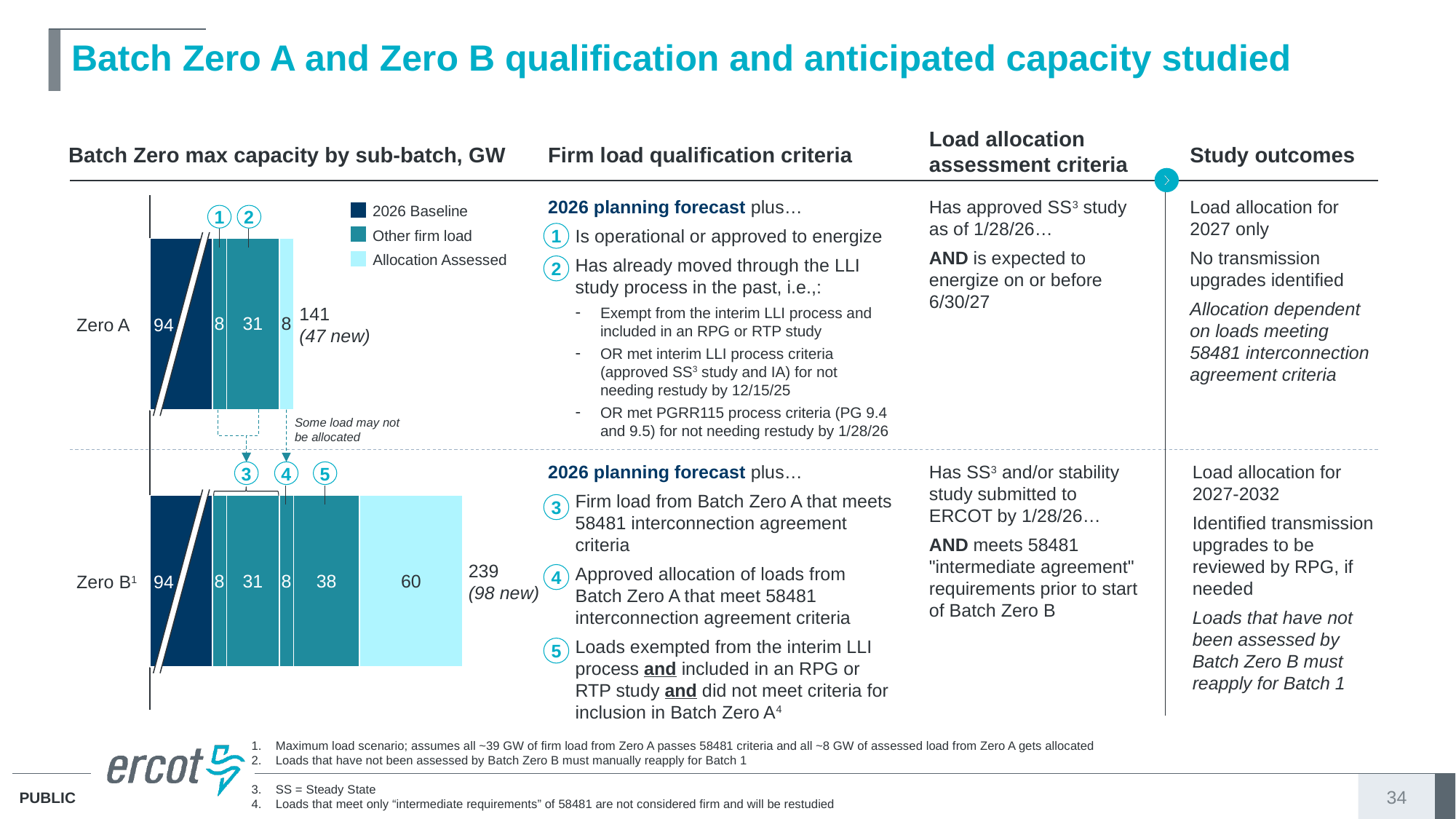
What is the total capacity shown for the Zero A bar, in GW? 141 How much new capacity is noted for Zero B? 98 new What is the value of the segment labelled 5 in the Zero B bar? 38 What is the value of the 2026 Baseline segment in the Zero A bar? 94 Which sub-batch has the higher total capacity, Zero A or Zero B? Zero B How many sub-batch bars are shown in the chart? 2 What is the difference between the Zero B total and the Zero A total, in GW? 98 What is the value of the largest Allocation Assessed segment in the Zero B bar? 60 How much new capacity is noted for Zero A? 47 new What type of chart is used to show Batch Zero max capacity by sub-batch? Stacked bar chart What is the total capacity shown for the Zero B bar, in GW? 239 How many entries does the chart legend list? 3